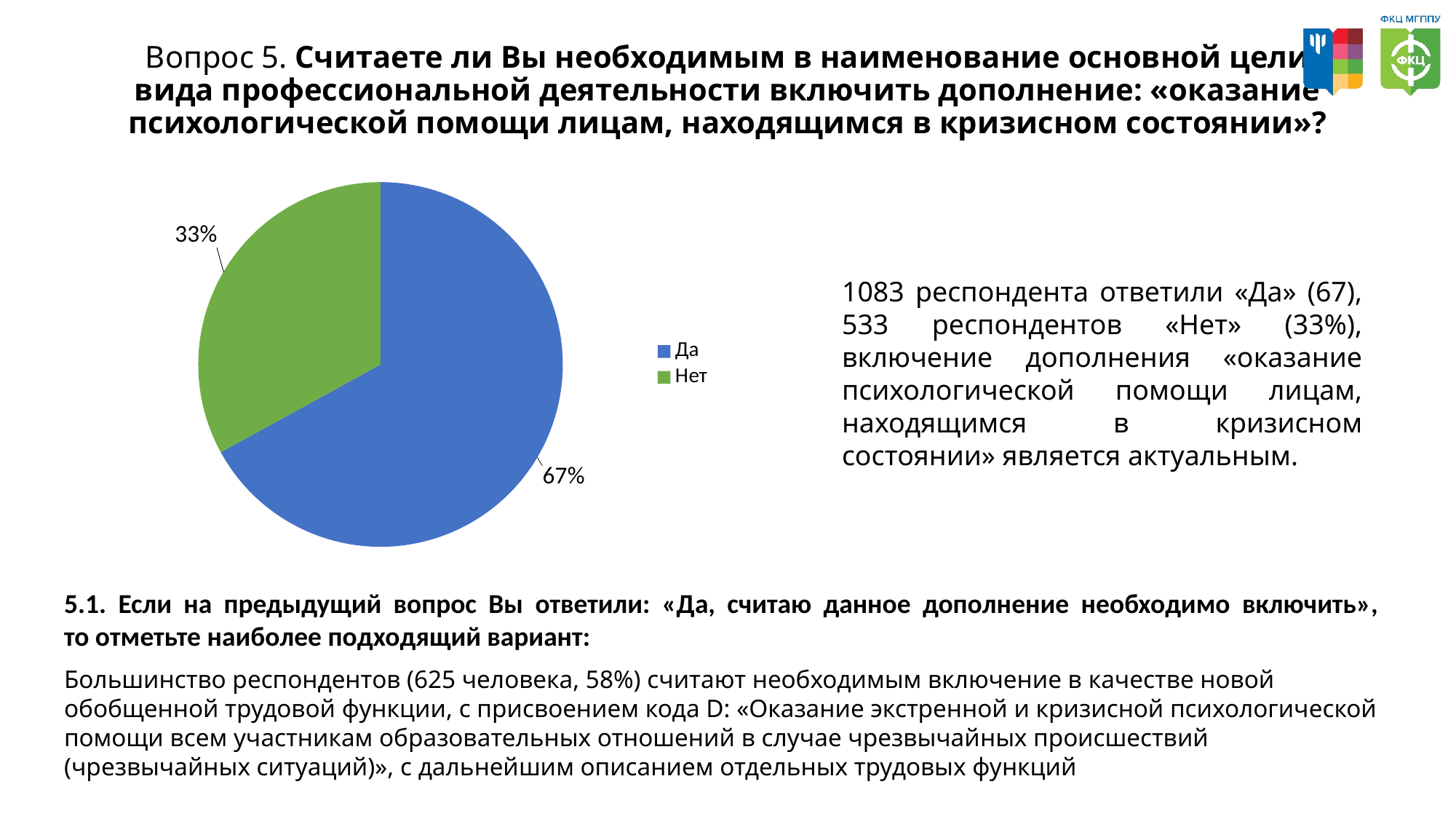
What is the difference in percentage points between the "Да" and "Нет" slices? 34% Which category has the smallest slice of the pie? Нет How many categories does the pie chart show? 2 What share of the pie does the "Да" slice represent? 67% Which slice is larger, "Да" or "Нет"? Да What colour is the "Да" slice in the pie chart? blue Which category has the largest slice of the pie? Да What colour is the "Нет" slice in the pie chart? green What share of the pie does the "Нет" slice represent? 33% How many entries does the legend list? 2 What kind of chart is shown on the slide? pie chart